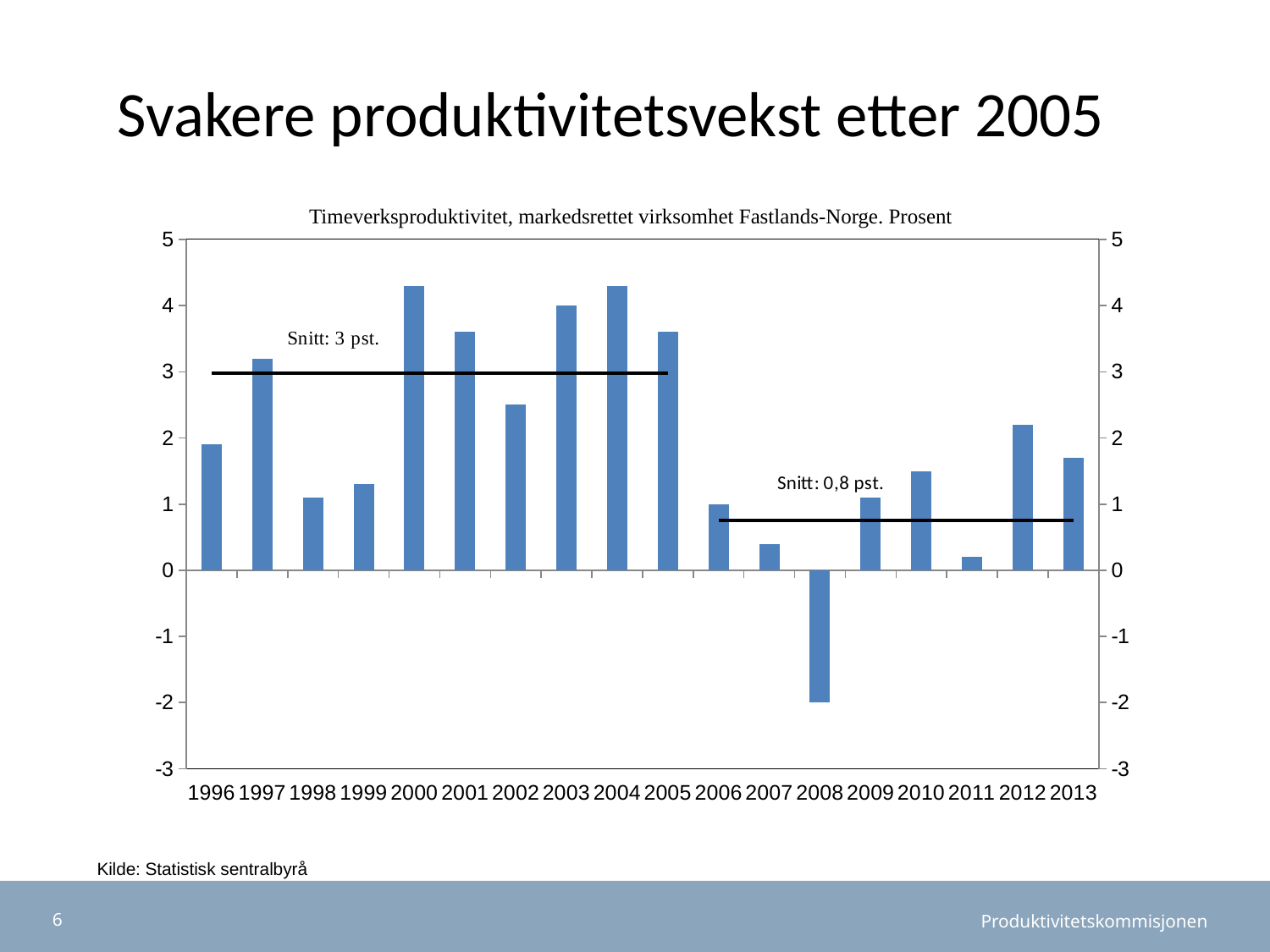
What is the title of the chart? Timeverksproduktivitet, markedsrettet virksomhet Fastlands-Norge. Prosent Is the value for 2012 greater or less than 2? greater Is the value for 2007 greater or less than 1? less What type of chart is shown on the slide? bar chart What is the value for 2008? -2 What average (snitt) is annotated for the period 1996–2005? Snitt: 3 pst. How many years are shown on the x axis of the chart? 18 Is the value for 2011 greater or less than 1? less Do the values rise or fall from 2005 to 2008? fall Which year has the lowest value in the chart? 2008 Which is larger, the value for 2001 or the value for 2002? 2001